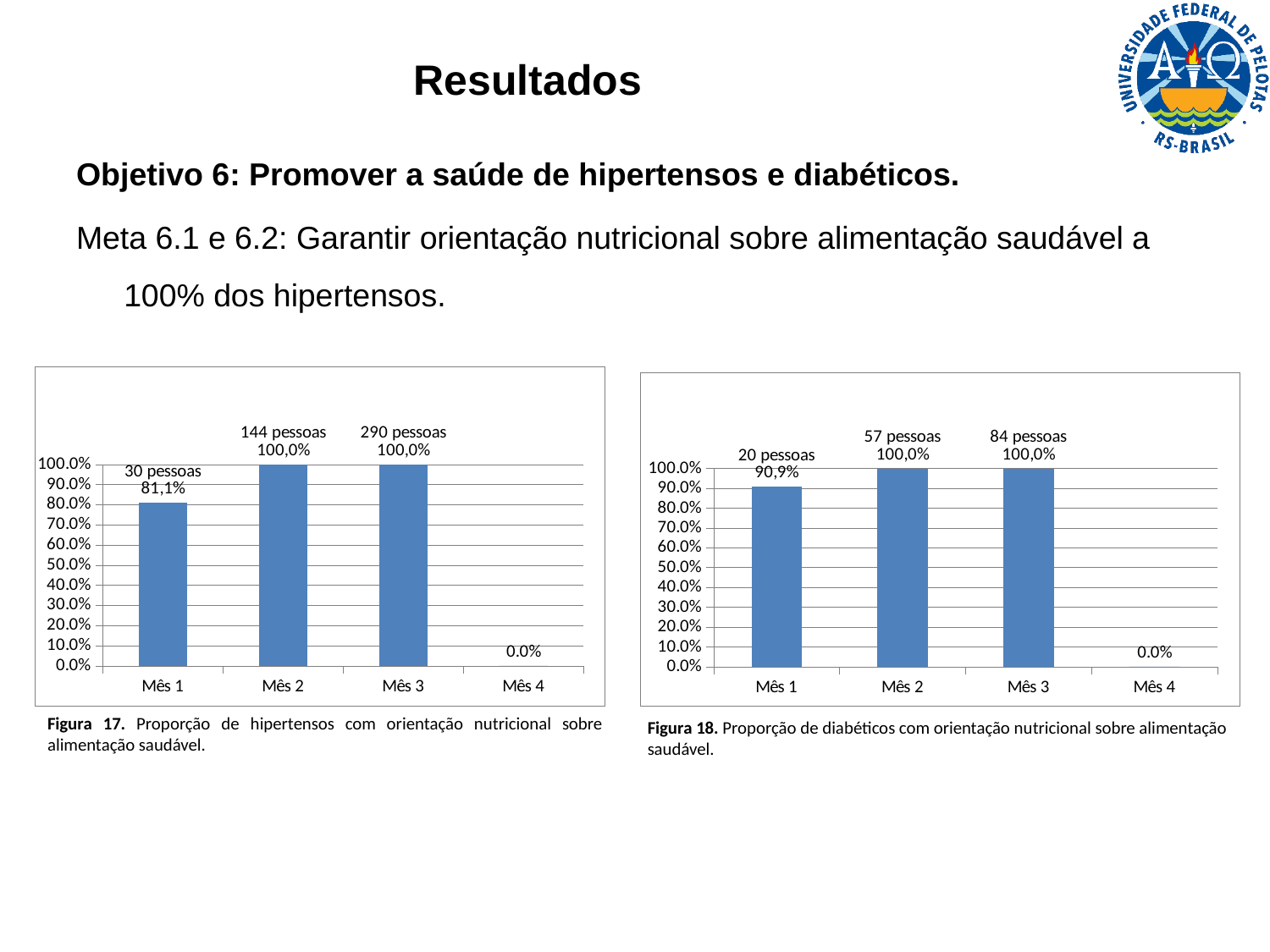
In the right chart (Figura 18), how many people does the label for Mês 2 report? 57 pessoas In the right chart (Figura 18), what is the value for Mês 1? 90,9% In the right chart (Figura 18), what is the difference between the values for Mês 3 and Mês 1? 9,1% In the left chart (Figura 17), what is the difference between the values for Mês 2 and Mês 1? 18,9% In the left chart (Figura 17), is the value for Mês 1 greater or less than 90.0%? less Which is larger: the value for Mês 1 in the left chart (Figura 17) or the value for Mês 1 in the right chart (Figura 18)? Mês 1 in the right chart (Figura 18) What kind of chart is the left chart (Figura 17)? Bar chart In the left chart (Figura 17), which month has the lowest value? Mês 4 In the left chart (Figura 17), what is the value for Mês 1? 81,1% How many months (categories) are shown on the x axis of the right chart (Figura 18)? 4 In the left chart (Figura 17), how many people does the label for Mês 3 report? 290 pessoas In the right chart (Figura 18), which month has the lowest value? Mês 4